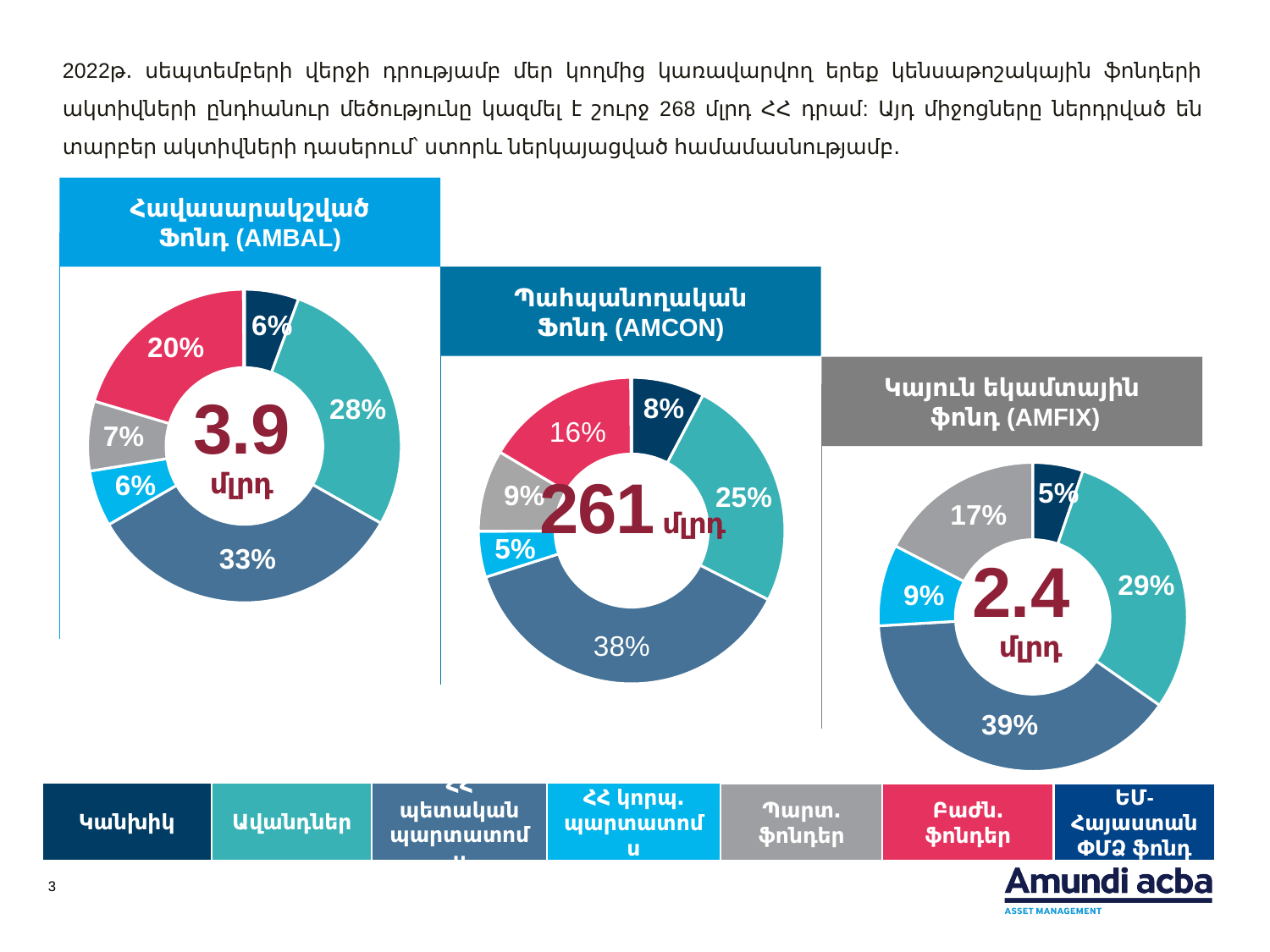
In the Հավասարակշված Ֆոնդ (AMBAL) chart, what share is shown for Ավանդներ (the teal segment)? 28% In the Հավասարակշված Ֆոնդ (AMBAL) chart, what is the largest share shown? 33% In the Պահպանողական Ֆոնդ (AMCON) chart, what is the largest share shown? 38% What total value is printed in the centre of the Հավասարակշված Ֆոնդ (AMBAL) chart? 3.9 մլրդ How many categories does the legend at the bottom of the slide list? 7 How many segments does the Կայուն եկամտային ֆոնդ (AMFIX) chart have? 5 What total value is printed in the centre of the Կայուն եկամտային ֆոնդ (AMFIX) chart? 2.4 մլրդ In the Կայուն եկամտային ֆոնդ (AMFIX) chart, what is the smallest share shown? 5% In the Պահպանողական Ֆոնդ (AMCON) chart, what share is shown for Բաժն. ֆոնդեր (the pink segment)? 16% In the Կայուն եկամտային ֆոնդ (AMFIX) chart, what share is shown for Պարտ. ֆոնդեր (the grey segment)? 17% What type of chart is used for the Հավասարակշված Ֆոնդ (AMBAL) on the slide? Donut (pie) chart What total value is printed in the centre of the Պահպանողական Ֆոնդ (AMCON) chart? 261 մլրդ